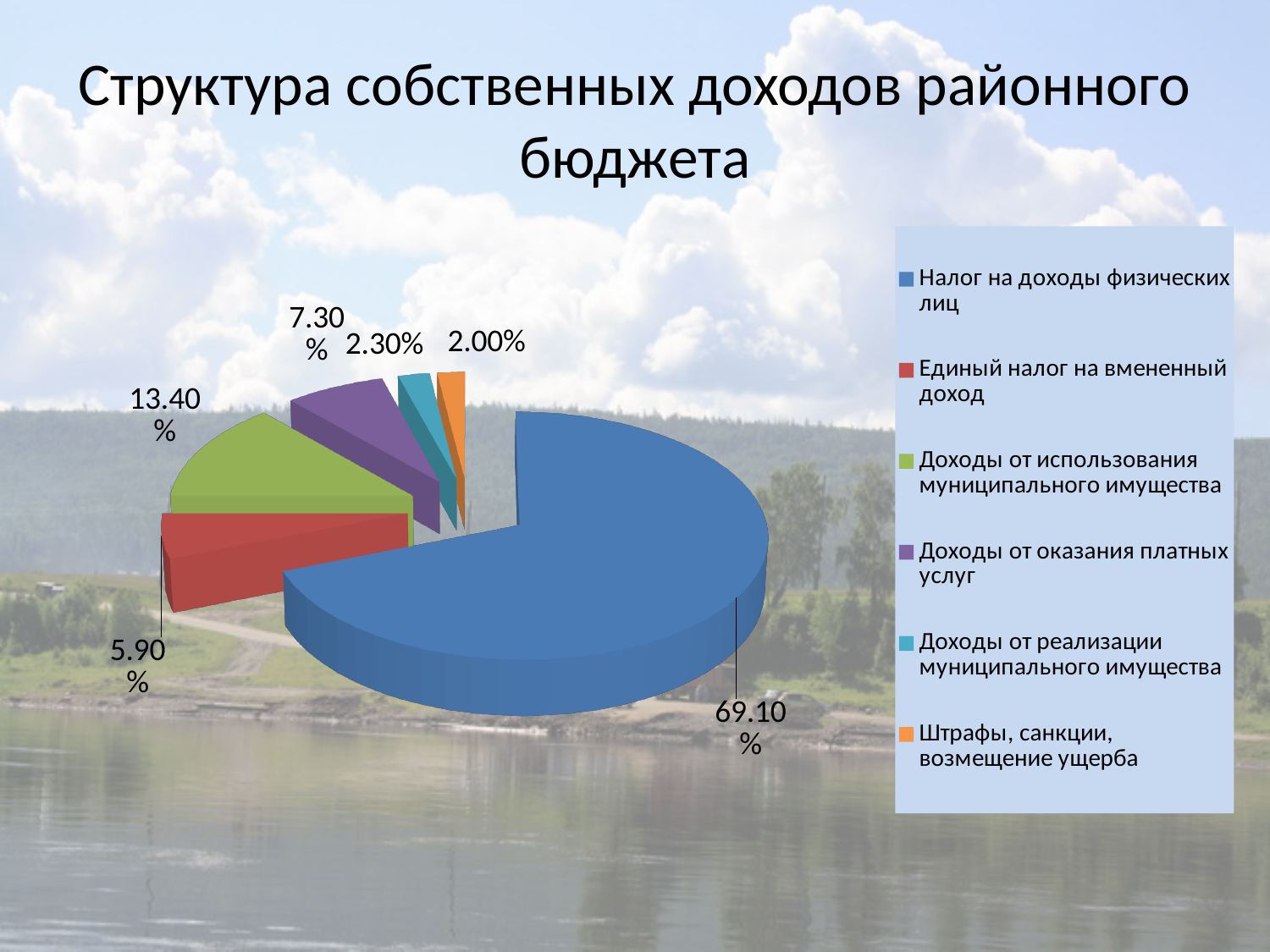
What is the share for Единый налог на вмененный доход? 5.90% What type of chart is shown on the slide? pie chart What is the share for Доходы от оказания платных услуг? 7.30% What is the share for Штрафы, санкции, возмещение ущерба? 2.00% Which is larger: the share for Единый налог на вмененный доход or the share for Доходы от оказания платных услуг? Доходы от оказания платных услуг What is the title of the chart on the slide? Структура собственных доходов районного бюджета What is the share for Доходы от использования муниципального имущества? 13.40% What is the difference between the shares of Доходы от использования муниципального имущества and Доходы от оказания платных услуг? 6.10% What is the share for Налог на доходы физических лиц? 69.10% Which category has the smallest share of the pie? Штрафы, санкции, возмещение ущерба How many categories does the legend list? 6 Which category has the largest share of the pie? Налог на доходы физических лиц